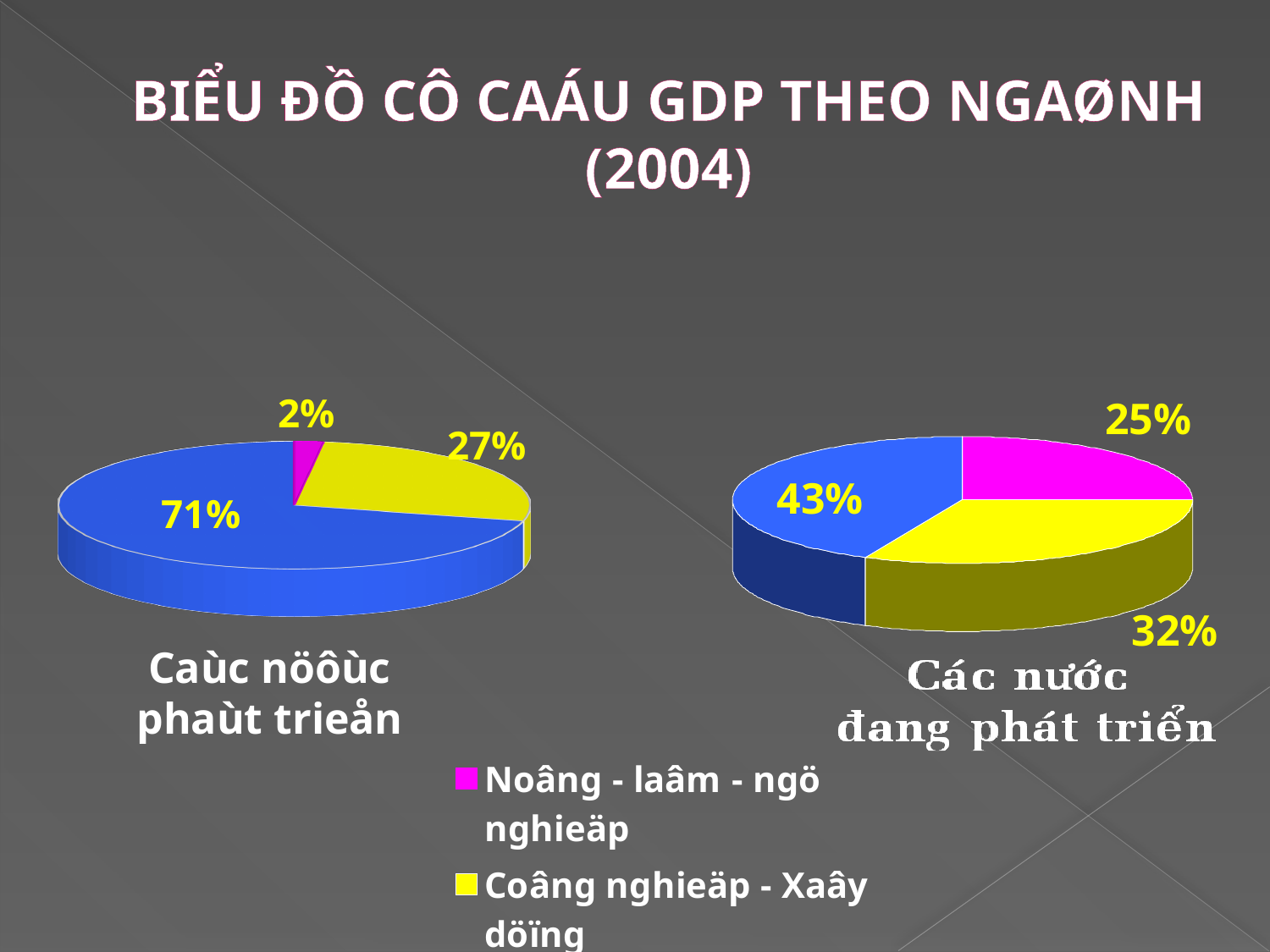
Which chart has the larger magenta slice (Noâng - laâm - ngö nghieäp): the left chart or the right chart? The right chart (25%) What year is given in the slide title? 2004 On the right pie chart (Các nước đang phát triển), what is the value of the magenta slice (Noâng - laâm - ngö nghieäp)? 25% On the left pie chart (Caùc nöôùc phaùt trieån), what is the value of the yellow slice (Coâng nghieäp - Xaây döïng)? 27% On the left pie chart (Caùc nöôùc phaùt trieån), what is the value of the magenta slice (Noâng - laâm - ngö nghieäp)? 2% On the right pie chart (Các nước đang phát triển), what is the value of the yellow slice (Coâng nghieäp - Xaây döïng)? 32% On the right pie chart (Các nước đang phát triển), what is the value of the smallest slice? 25% On the right pie chart (Các nước đang phát triển), what is the difference between the blue slice (43%) and the yellow slice (32%)? 11 percentage points What kind of charts are shown on the slide? Pie charts On the left pie chart (Caùc nöôùc phaùt trieån), what is the value of the largest slice? 71% On the right pie chart (Các nước đang phát triển), what is the value of the largest slice? 43% How many slices does the left pie chart (Caùc nöôùc phaùt trieån) have? 3